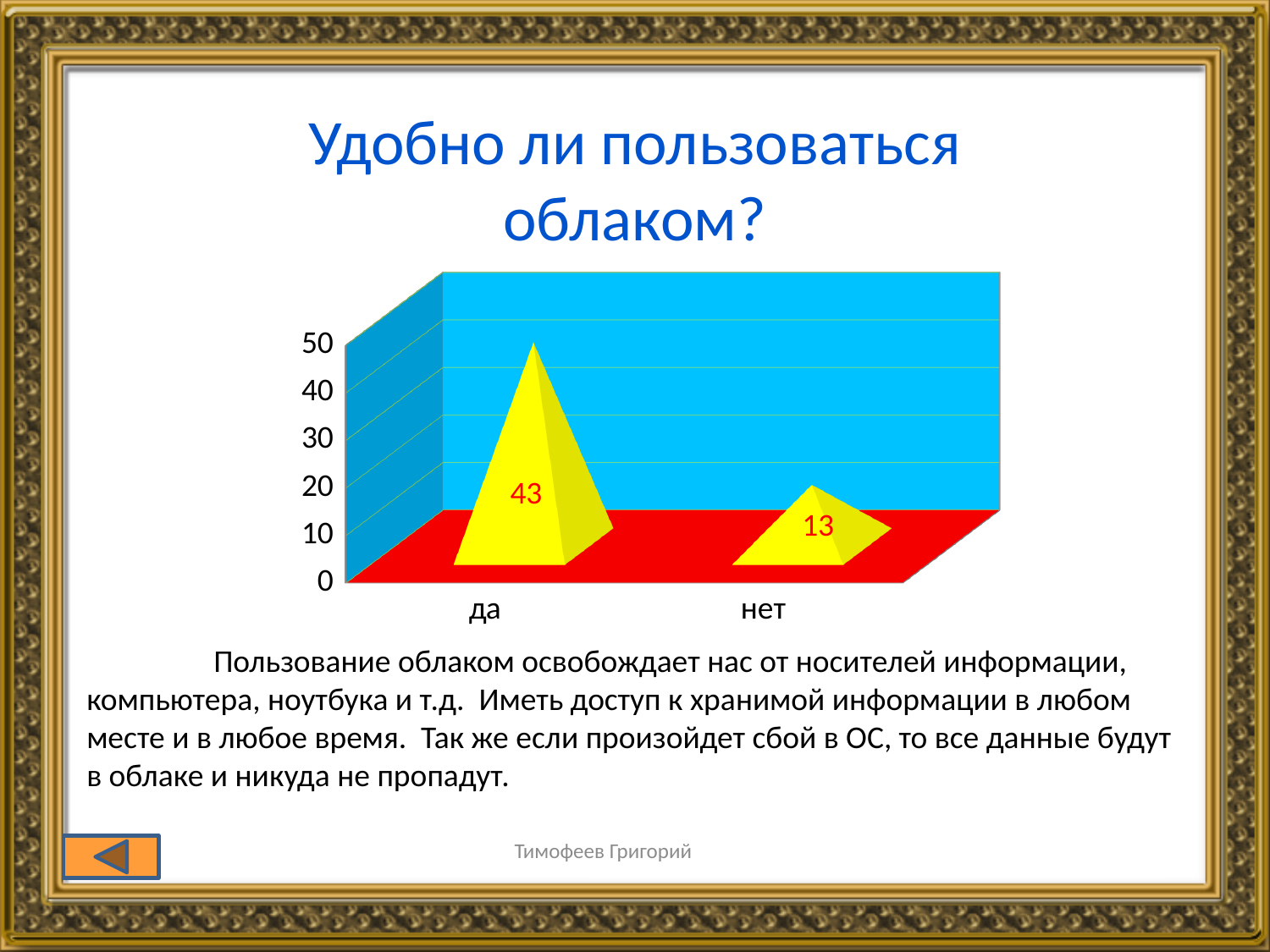
What kind of chart is shown on the slide? bar chart What is the difference between the values for "да" and "нет"? 30 Which category has the highest value? да What is the title of the slide containing the chart? Удобно ли пользоваться облаком? Is the value for "да" greater or less than 40? greater How many categories are shown on the x axis? 2 Which is larger, the value for "да" or the value for "нет"? да Is the value for "нет" greater or less than 20? less What is the total of the two values shown in the chart? 56 What is the value for "нет"? 13 What is the value for "да"? 43 Which category has the lowest value? нет